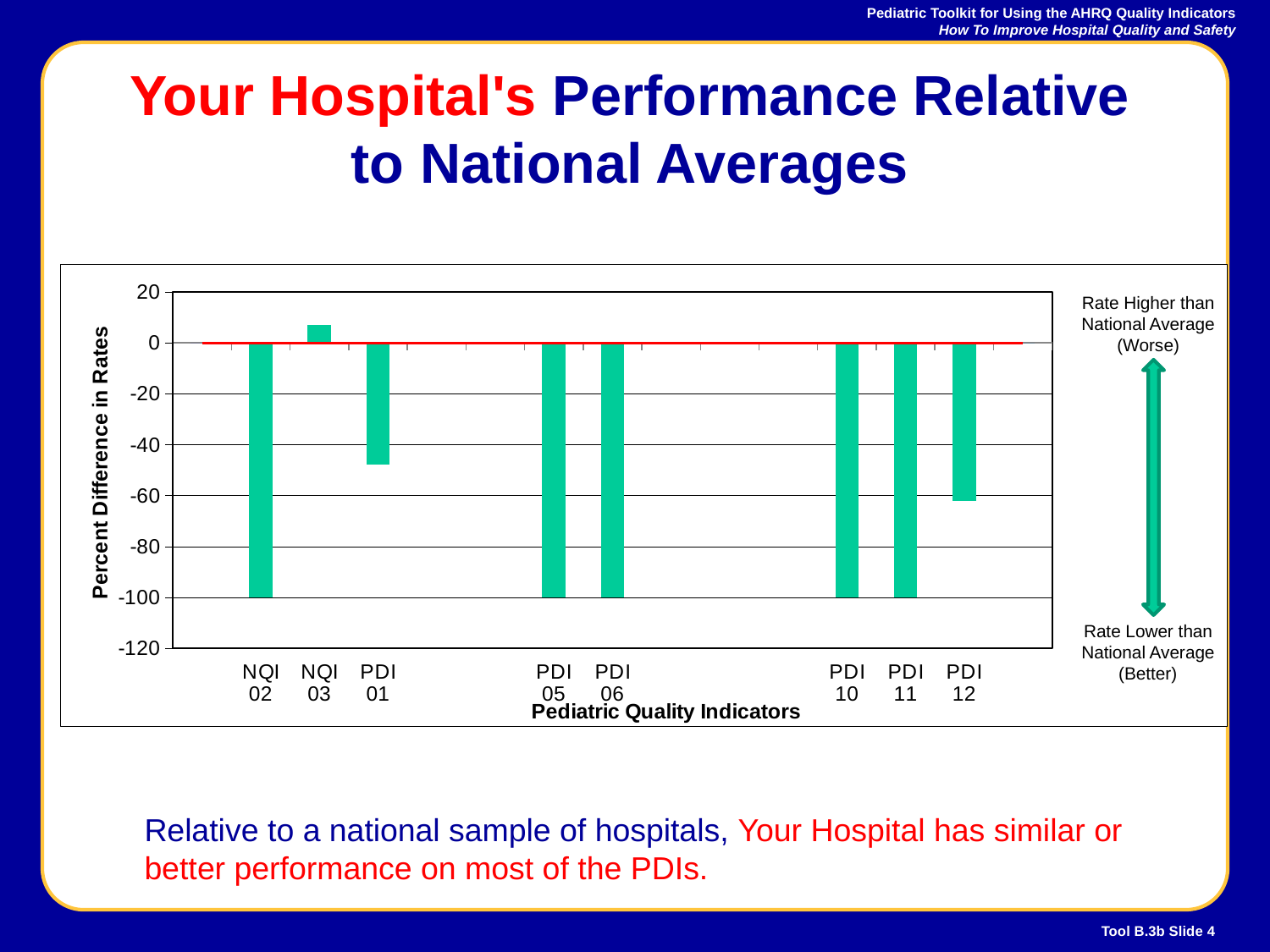
What is the percent difference in rates for PDI 05? -100 What is the title of the x axis of the chart? Pediatric Quality Indicators What is the percent difference in rates for NQI 02? -100 What is the percent difference in rates for PDI 11? -100 Which indicator has the highest value in the chart? NQI 03 What kind of chart is shown on the slide? bar chart Is the value for NQI 03 greater or less than 0? greater How many indicators are labeled on the x axis of the chart? 8 Is the value for PDI 12 greater or less than -40? less What is the title of the y axis of the chart? Percent Difference in Rates Is the value for PDI 01 greater or less than -40? less Which has the larger value, PDI 01 or PDI 12? PDI 01